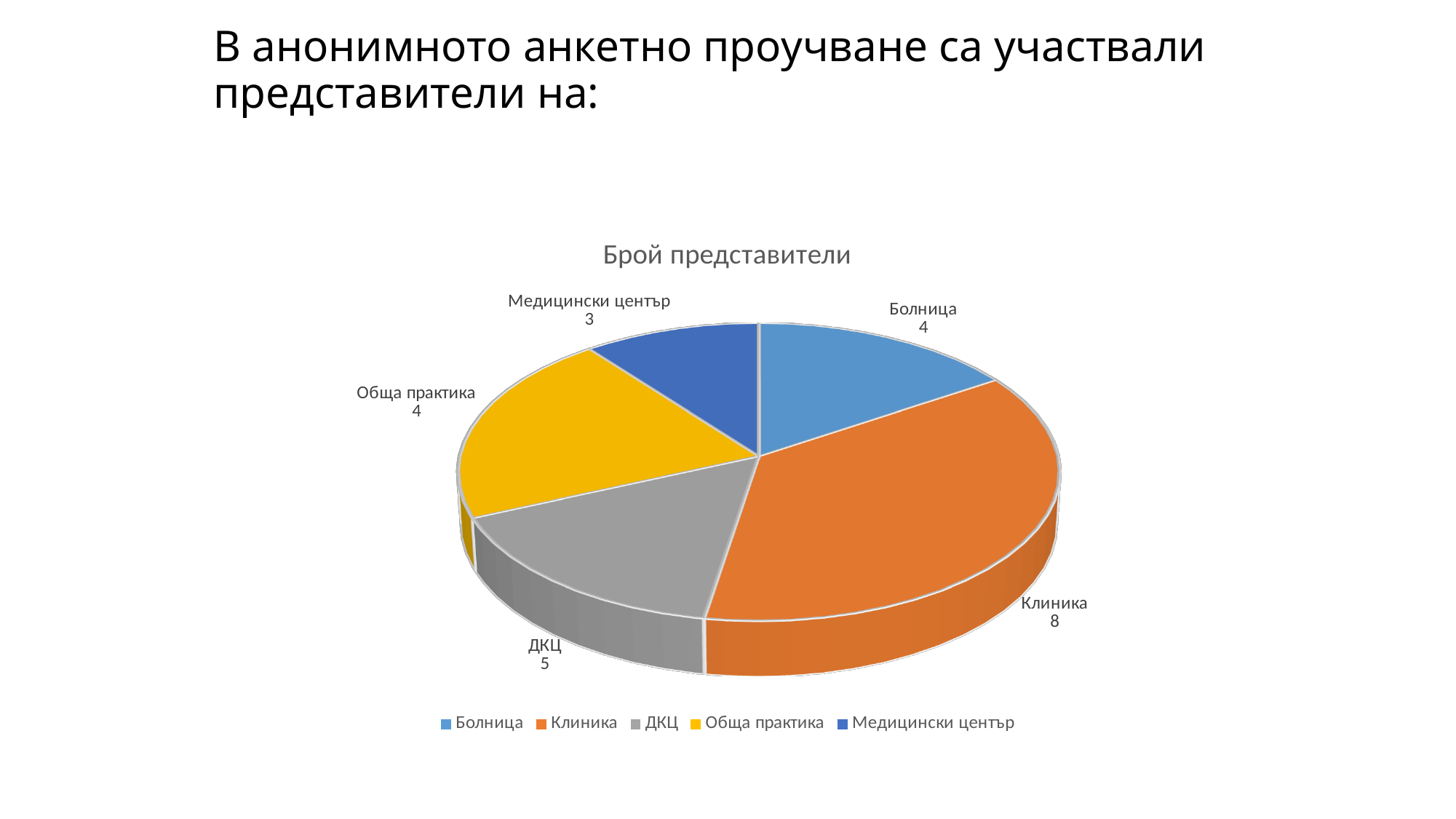
Which category has the largest slice? Клиника What is the value for Медицински център? 3 What is the difference between the values for Клиника and ДКЦ? 3 What kind of chart is shown on the slide? pie chart How many slices does the pie chart have? 5 What is the title of the chart? Брой представители What is the value for Болница? 4 What is the value for Клиника? 8 Which category has the smallest slice? Медицински център What is the total of all slices in the pie chart? 24 Which is larger, the value for ДКЦ or the value for Обща практика? ДКЦ What is the value for ДКЦ? 5